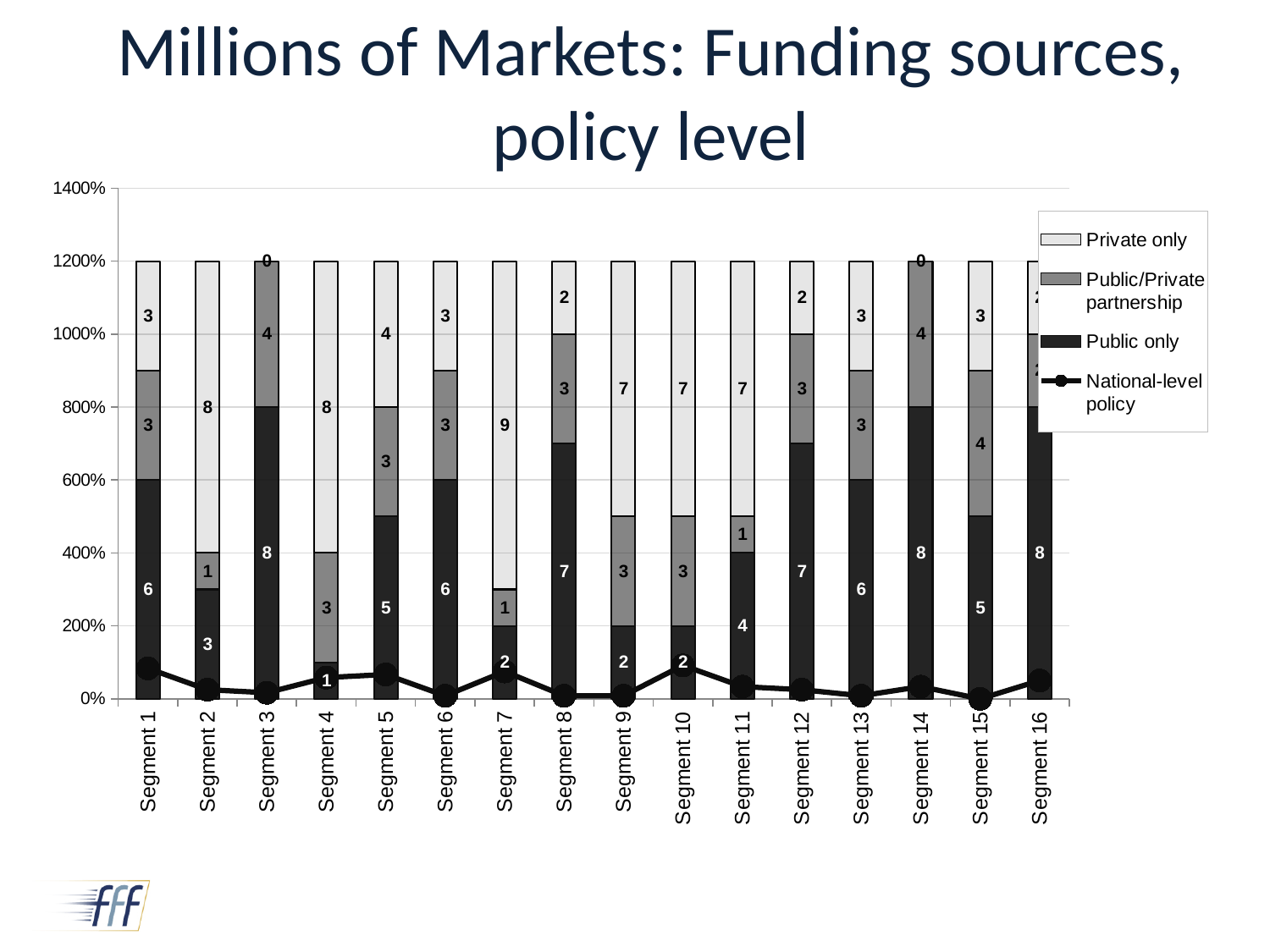
Which is larger, the Private only value for Segment 4 or for Segment 5? Segment 4 What is the difference between the Public only values for Segment 3 and Segment 2? 5 What is the Private only value for Segment 7? 9 Which segment has the lowest Public only value? Segment 4 What is the total of the three stacked values for Segment 1? 12 How many segments are shown on the x axis? 16 Which segment has the highest Private only value? Segment 7 How many series does the legend list? 4 What is the Public only value for Segment 1? 6 What kind of chart is shown on the slide? Stacked bar chart with a line Which series is drawn as a line with markers? National-level policy What is the Public/Private partnership value for Segment 15? 4